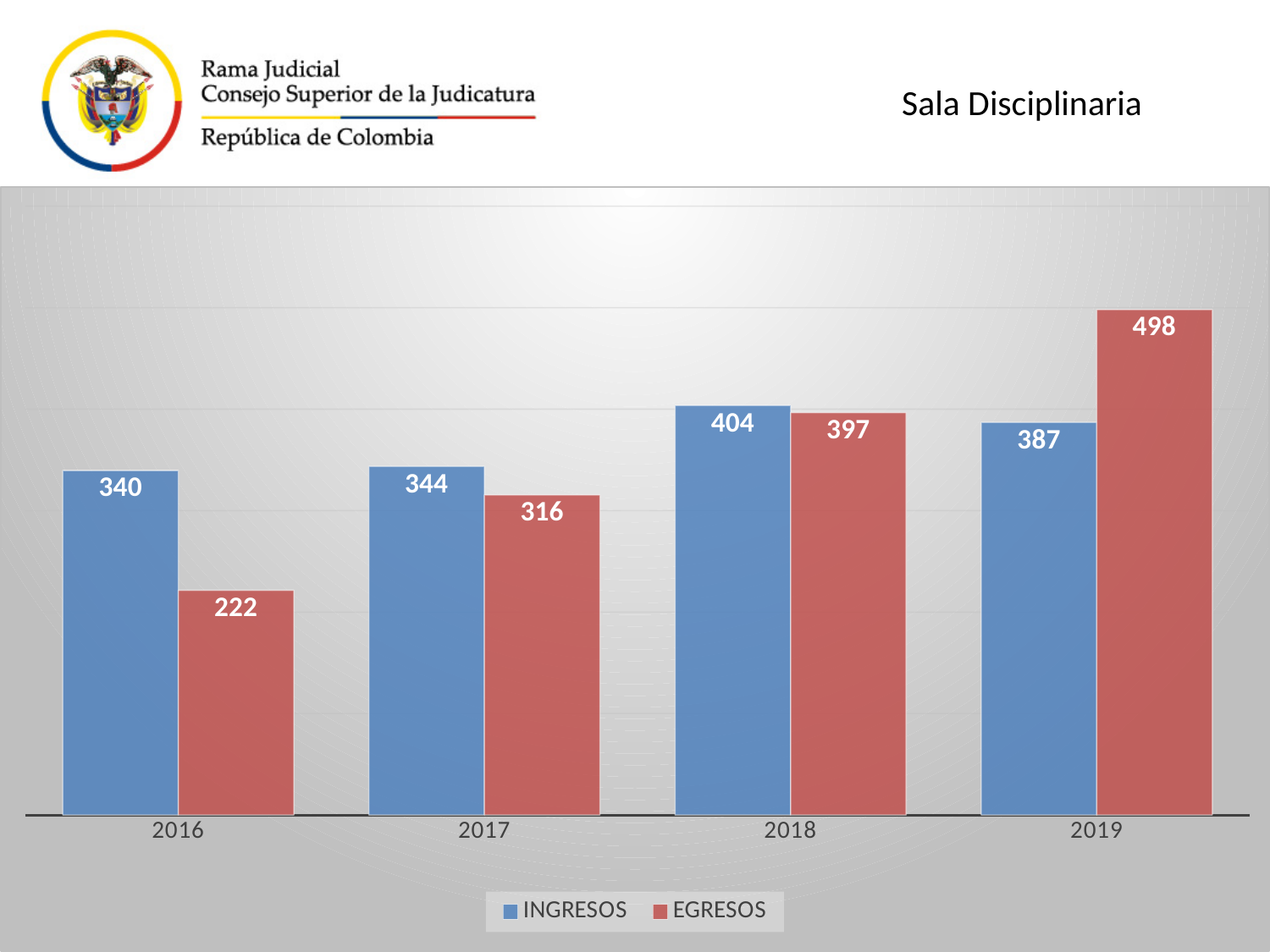
Which year has the highest INGRESOS value? 2018 What is the difference between EGRESOS in 2019 and EGRESOS in 2018? 101 What is the EGRESOS value for 2017? 316 Do the EGRESOS values rise or fall from 2016 to 2019? Rise How many years are shown on the x axis? 4 What kind of chart is shown on the slide? Bar chart What is the difference between INGRESOS and EGRESOS in 2016? 118 In 2019, which is larger, INGRESOS or EGRESOS? EGRESOS How many series does the legend list? 2 What is the INGRESOS value for 2016? 340 What is the EGRESOS value for 2019? 498 Which year has the lowest EGRESOS value? 2016